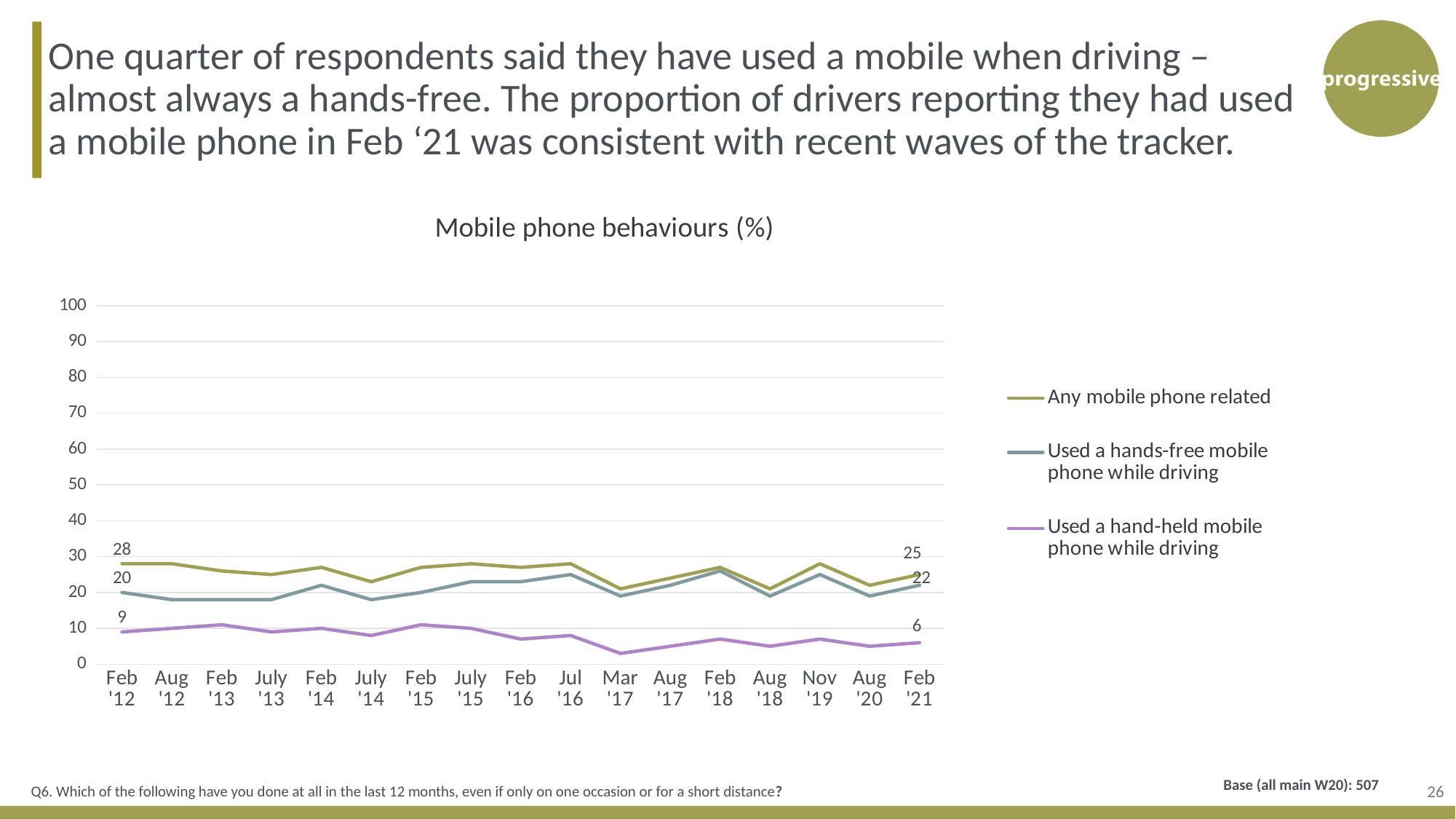
What is the value for 'Any mobile phone related' in Feb '12? 28 How many time points are shown on the x axis? 17 What kind of chart is shown on the slide? Line chart What is the value for 'Used a hands-free mobile phone while driving' in Feb '21? 22 Which series has the lowest values across the whole period? Used a hand-held mobile phone while driving What is the value for 'Used a hand-held mobile phone while driving' in Feb '12? 9 What is the value for 'Any mobile phone related' in Feb '21? 25 What is the difference between the 'Any mobile phone related' values in Feb '12 and Feb '21? 3 What is the difference between 'Used a hands-free mobile phone while driving' and 'Used a hand-held mobile phone while driving' in Feb '21? 16 Is the value for 'Used a hands-free mobile phone while driving' in Mar '17 greater or less than 30? less How many series does the legend list? 3 What is the title of the chart? Mobile phone behaviours (%)